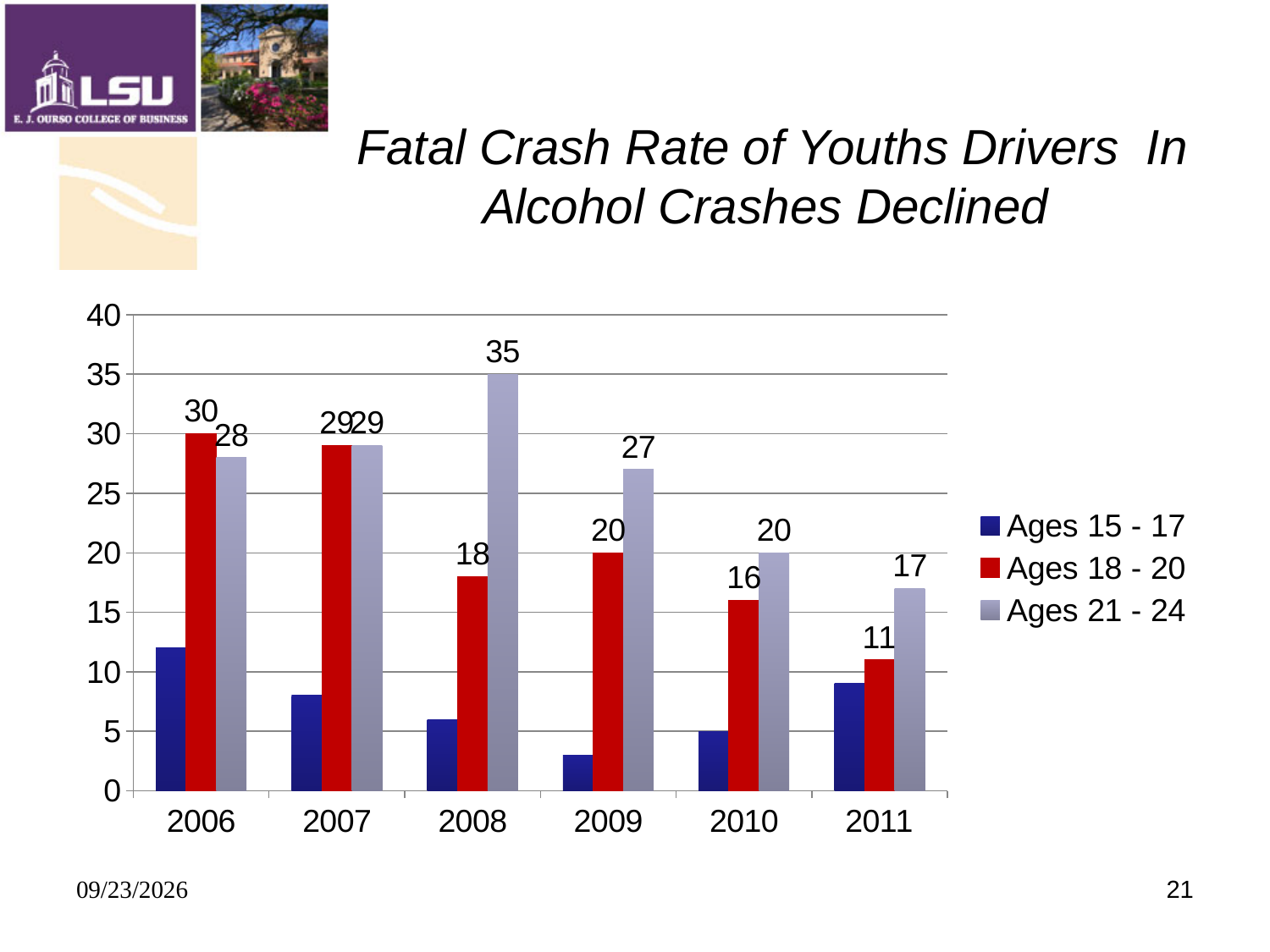
What is the value for Ages 21 - 24 in 2008? 35 How many series does the legend list? 3 In 2008, what is the difference between the Ages 21 - 24 value and the Ages 18 - 20 value? 17 What kind of chart is shown on the slide? bar chart In which year is the value for Ages 21 - 24 the highest? 2008 In which year is the value for Ages 18 - 20 the lowest? 2011 What is the value for Ages 18 - 20 in 2006? 30 How many years are shown on the x axis? 6 Is the value for Ages 15 - 17 in 2006 greater or less than 10? greater Is the value for Ages 15 - 17 in 2009 greater or less than 5? less In 2009, which series has the larger value, Ages 18 - 20 or Ages 21 - 24? Ages 21 - 24 Overall, do the values for Ages 18 - 20 rise or fall from 2006 to 2011? fall